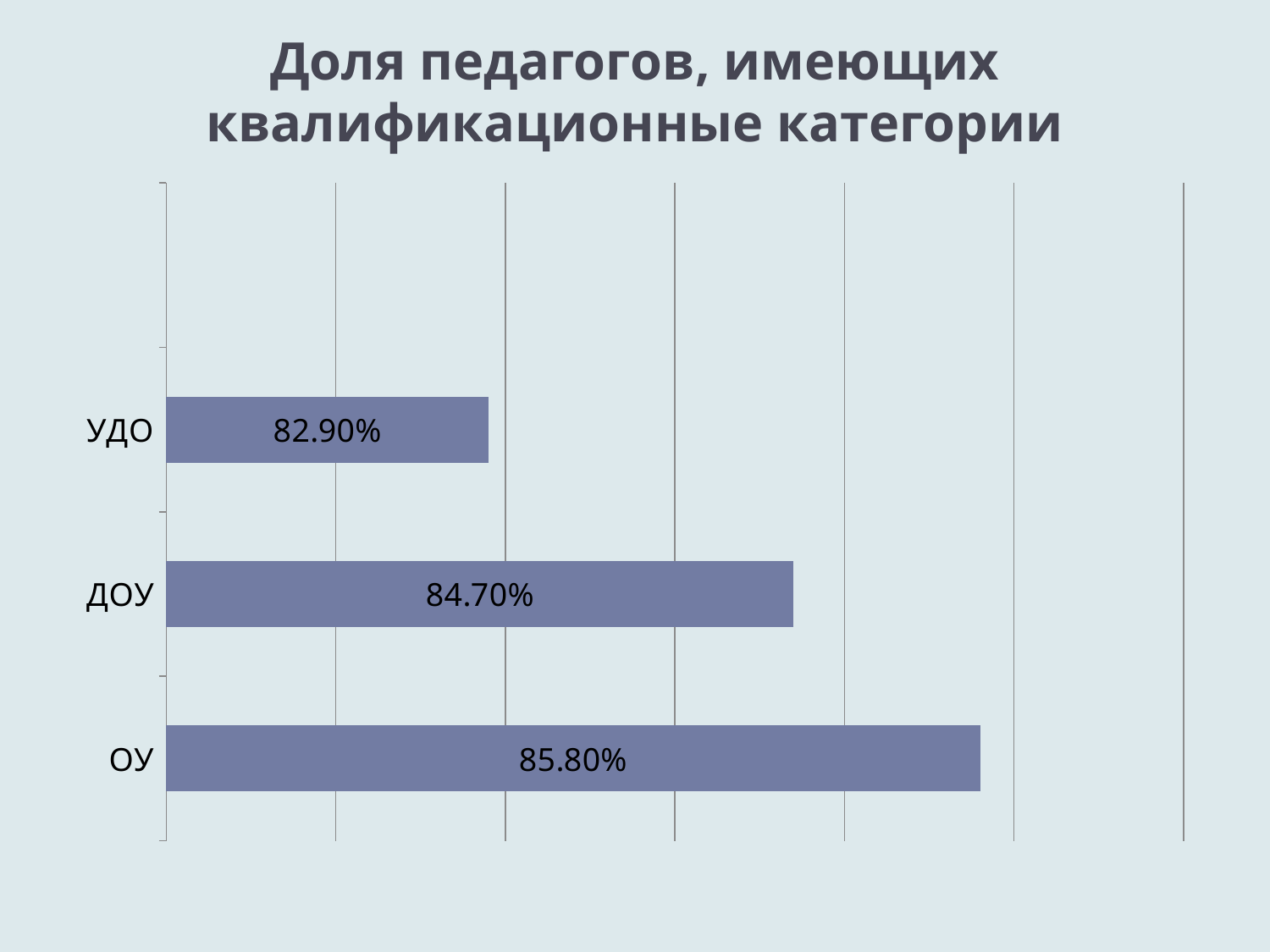
What kind of chart is shown on the slide? Bar chart What is the value for ДОУ? 84.70% What is the difference between the values for ДОУ and УДО? 1.80% What is the value for ОУ? 85.80% What is the value for УДО? 82.90% How many categories are shown in the chart? 3 Which is larger, the value for ДОУ or the value for УДО? ДОУ What is the difference between the values for ОУ and ДОУ? 1.10% Which category has the lowest value? УДО Which category has the highest value? ОУ What is the title of the chart? Доля педагогов, имеющих квалификационные категории What is the difference between the values for ОУ and УДО? 2.90%